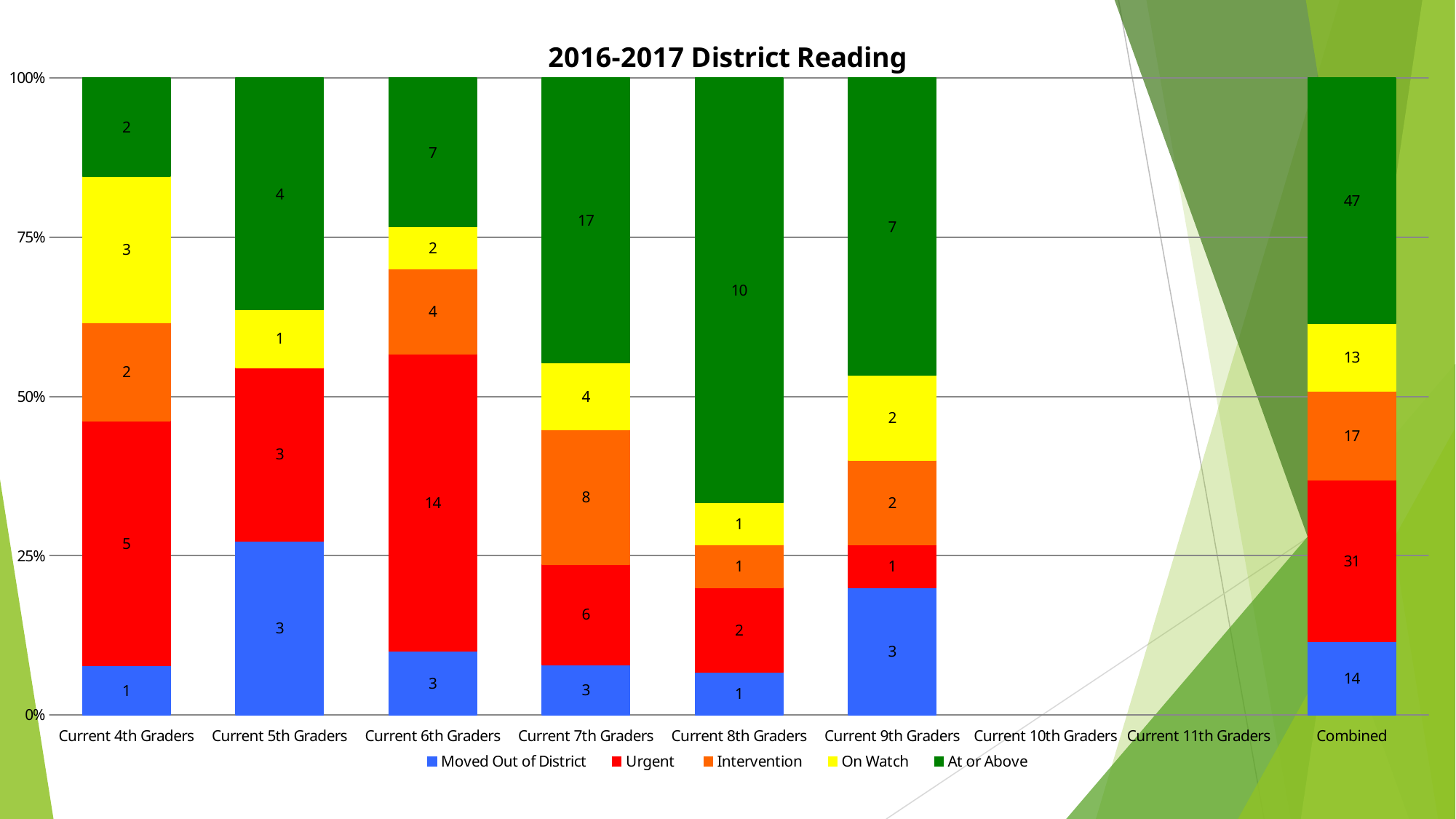
What is the total of all segments in the Current 7th Graders bar? 38 What is the total of all segments in the Combined bar? 122 How many series does the legend list? 5 What kind of chart is shown on the slide? Stacked bar chart What is the At or Above value for the Combined bar? 47 Which is larger: the At or Above value for Current 7th Graders or for Current 8th Graders? Current 7th Graders What is the title of the chart? 2016-2017 District Reading Which category has the highest At or Above value? Combined What is the Moved Out of District value for Current 8th Graders? 1 What is the Urgent value for Current 6th Graders? 14 What is the difference between the Urgent and On Watch values in the Combined bar? 18 What is the Intervention value for Current 7th Graders? 8